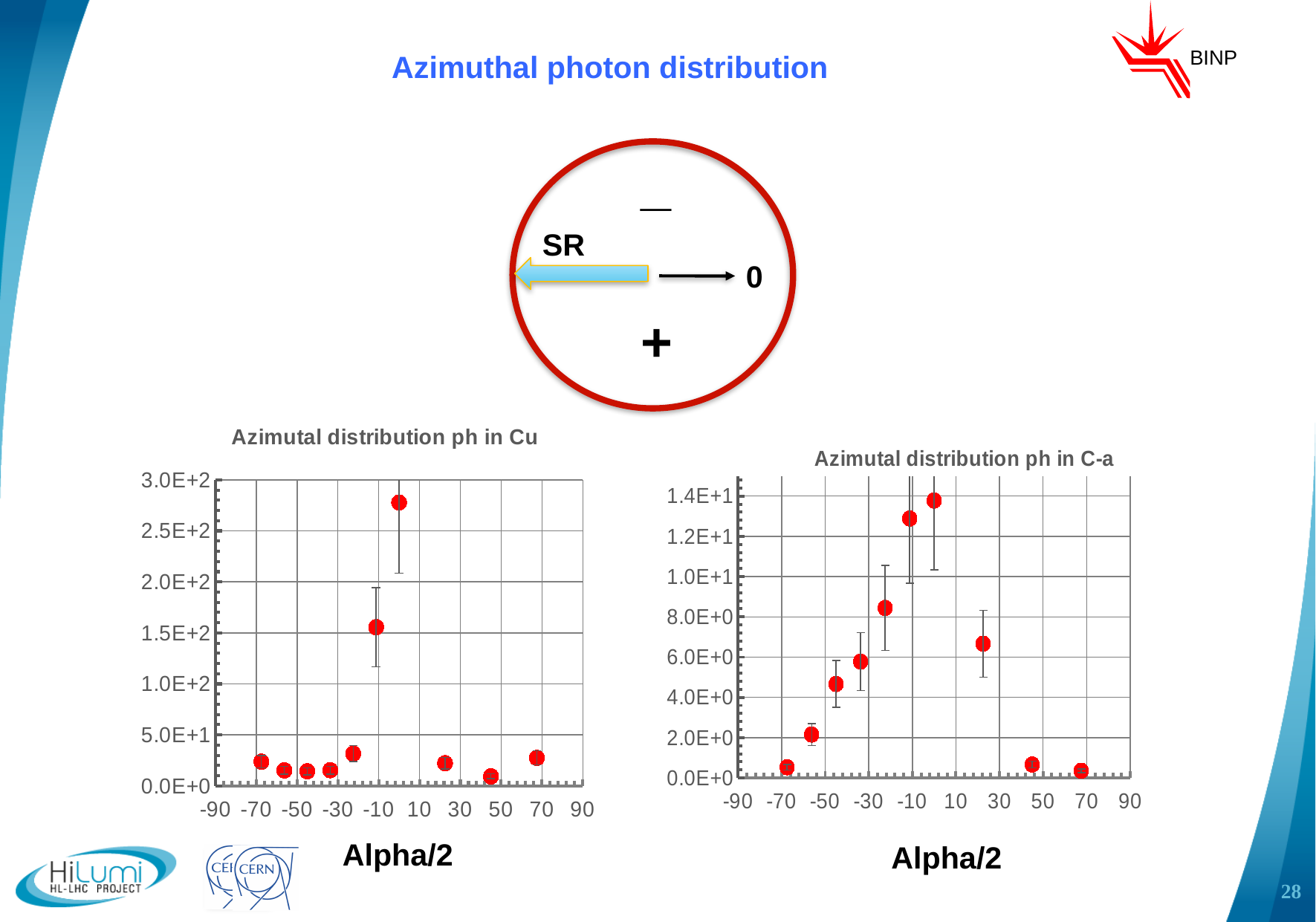
What type of chart is the 'Azimutal distribution ph in Cu' chart? scatter chart How many data points are plotted in the 'Azimutal distribution ph in C-a' chart? 10 How many data points are plotted in the 'Azimutal distribution ph in Cu' chart? 10 In the 'Azimutal distribution ph in C-a' chart, do the values rise or fall as Alpha/2 goes from -70 to 0? rise In the 'Azimutal distribution ph in Cu' chart, is the highest point greater or less than 2.5E+2? greater In the 'Azimutal distribution ph in C-a' chart, is the point at Alpha/2 of about 20 greater or less than 6.0E+0? greater In the 'Azimutal distribution ph in C-a' chart, at which Alpha/2 value is the highest point? 0 What is the x-axis label shown under both charts? Alpha/2 In the 'Azimutal distribution ph in Cu' chart, at which Alpha/2 value is the highest point? 0 In the 'Azimutal distribution ph in C-a' chart, is the point at Alpha/2 of about 50 greater or less than 2.0E+0? less In the 'Azimutal distribution ph in Cu' chart, which is larger: the point at Alpha/2 of about -10 or the point at about 20? the point at about -10